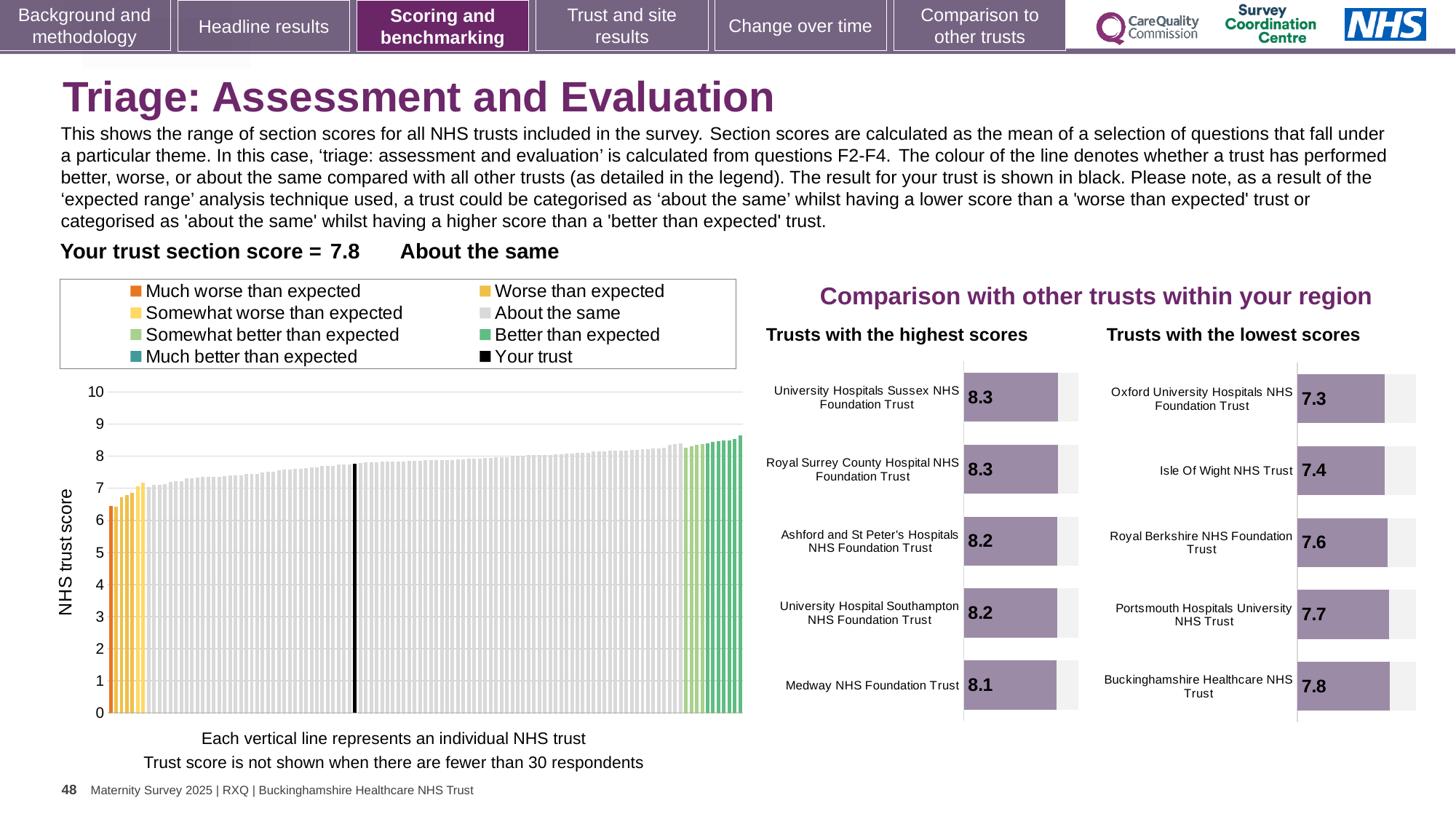
In the 'Trusts with the lowest scores' chart, which has the higher score: Royal Berkshire NHS Foundation Trust or Portsmouth Hospitals University NHS Trust? Portsmouth Hospitals University NHS Trust In the 'Trusts with the lowest scores' chart, which trust has the lowest score? Oxford University Hospitals NHS Foundation Trust In the 'Trusts with the highest scores' chart, what is the score for Medway NHS Foundation Trust? 8.1 How many trusts are listed in the 'Trusts with the highest scores' chart? 5 In the 'NHS trust score' chart, is the value of the black 'Your trust' bar greater or less than 5? greater In the 'Trusts with the lowest scores' chart, what is the score for Oxford University Hospitals NHS Foundation Trust? 7.3 In the 'Trusts with the lowest scores' chart, what is the score for Isle Of Wight NHS Trust? 7.4 In the 'Trusts with the highest scores' chart, what is the difference between the scores of University Hospitals Sussex NHS Foundation Trust and Medway NHS Foundation Trust? 0.2 How many entries does the legend above the 'NHS trust score' chart list? 8 In the 'Trusts with the lowest scores' chart, what is the difference between the scores of Buckinghamshire Healthcare NHS Trust and Oxford University Hospitals NHS Foundation Trust? 0.5 In the 'Trusts with the lowest scores' chart, which trust has the highest score? Buckinghamshire Healthcare NHS Trust What kind of chart is the large 'NHS trust score' chart on the left of the slide? bar chart